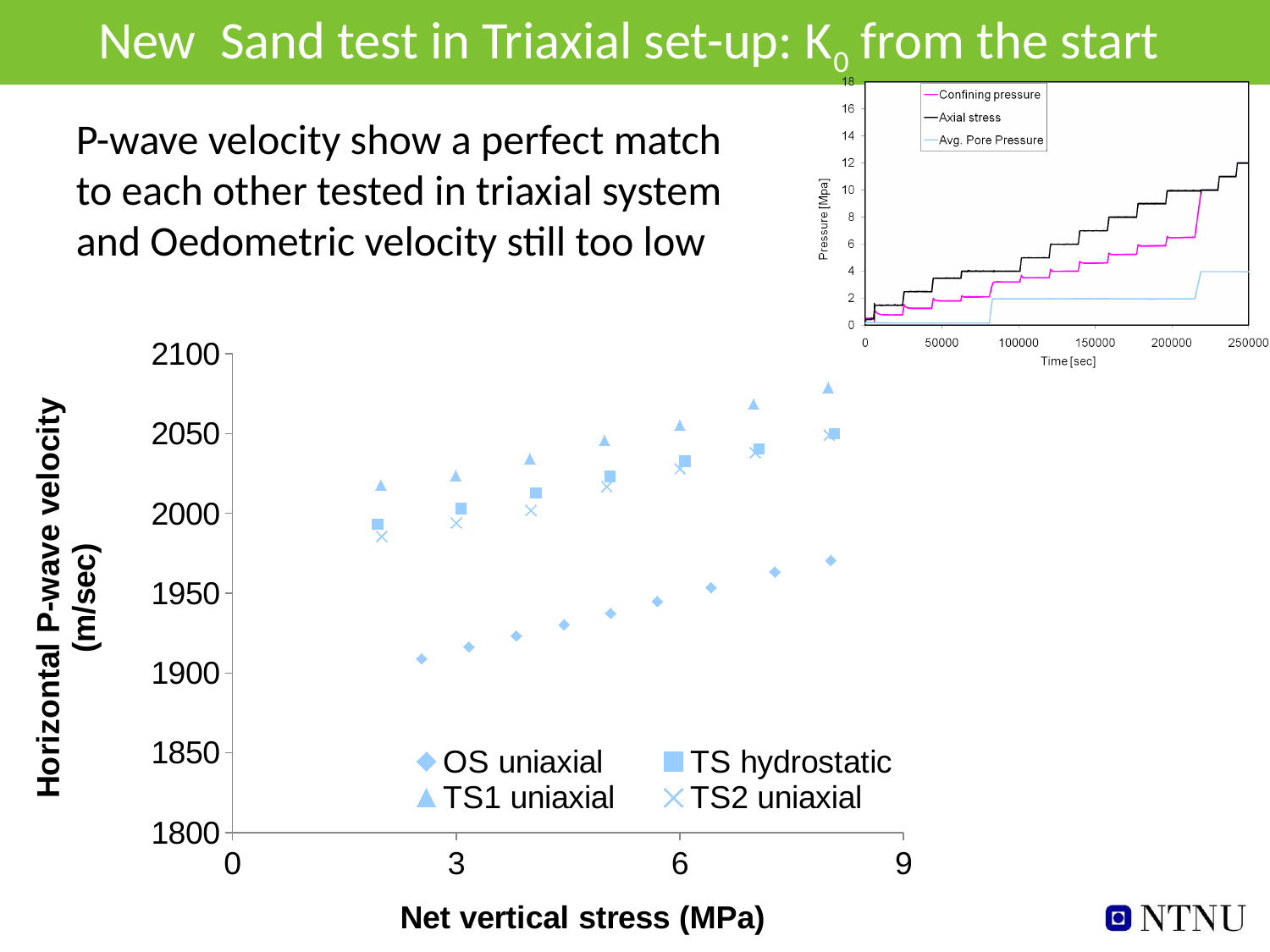
How many series does the legend of the large P-wave velocity chart list? 4 In the large P-wave velocity chart, is the TS1 uniaxial value at 8 MPa greater or less than 2050 m/sec? greater In the large P-wave velocity chart, does the OS uniaxial velocity rise or fall as net vertical stress increases? rise What is the x-axis label of the large P-wave velocity chart? Net vertical stress (MPa) In the large P-wave velocity chart, which series has the lowest velocities across the stress range? OS uniaxial In the large P-wave velocity chart, is the OS uniaxial value at 8 MPa greater or less than 2000 m/sec? less How many series does the legend of the small Pressure vs Time chart in the top right list? 3 In the large P-wave velocity chart, is the TS1 uniaxial value at 2 MPa greater or less than 2000 m/sec? greater In the large P-wave velocity chart, at 8 MPa, which is larger: the TS1 uniaxial value or the OS uniaxial value? TS1 uniaxial In the large P-wave velocity chart, which series has the highest velocities across the stress range? TS1 uniaxial What kind of chart is the large chart of Horizontal P-wave velocity against Net vertical stress? scatter chart